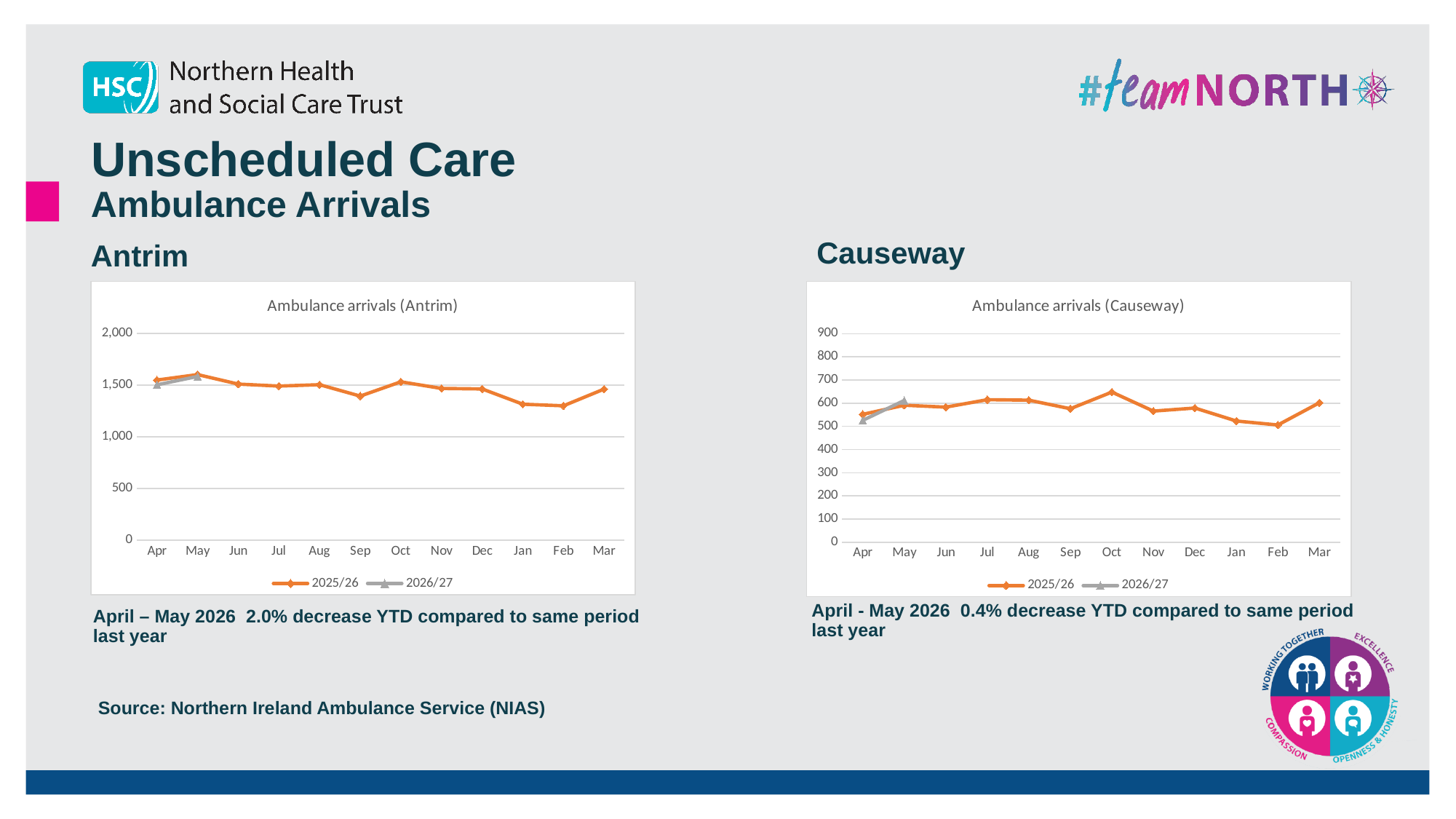
How many months are shown on the x axis of the Ambulance arrivals (Antrim) chart? 12 In the Ambulance arrivals (Antrim) chart, which month has the highest 2025/26 value? May In the Ambulance arrivals (Causeway) chart, is the 2025/26 value for Oct larger or smaller than the value for Jan? larger In the Ambulance arrivals (Antrim) chart, is the 2025/26 value for Feb greater or less than 1,500? less In the Ambulance arrivals (Causeway) chart, is the 2025/26 value for Oct greater or less than 600? greater In the Ambulance arrivals (Causeway) chart, is the 2025/26 value for Feb greater or less than 600? less In the Ambulance arrivals (Antrim) chart, does the 2025/26 line rise or fall from Dec to Jan? fall What are the two series named in the legend of the Ambulance arrivals (Antrim) chart? 2025/26 and 2026/27 In the Ambulance arrivals (Causeway) chart, which month has the highest 2025/26 value? Oct How many series does the legend of the Ambulance arrivals (Causeway) chart list? 2 What kind of chart is the Ambulance arrivals (Antrim) chart? line chart